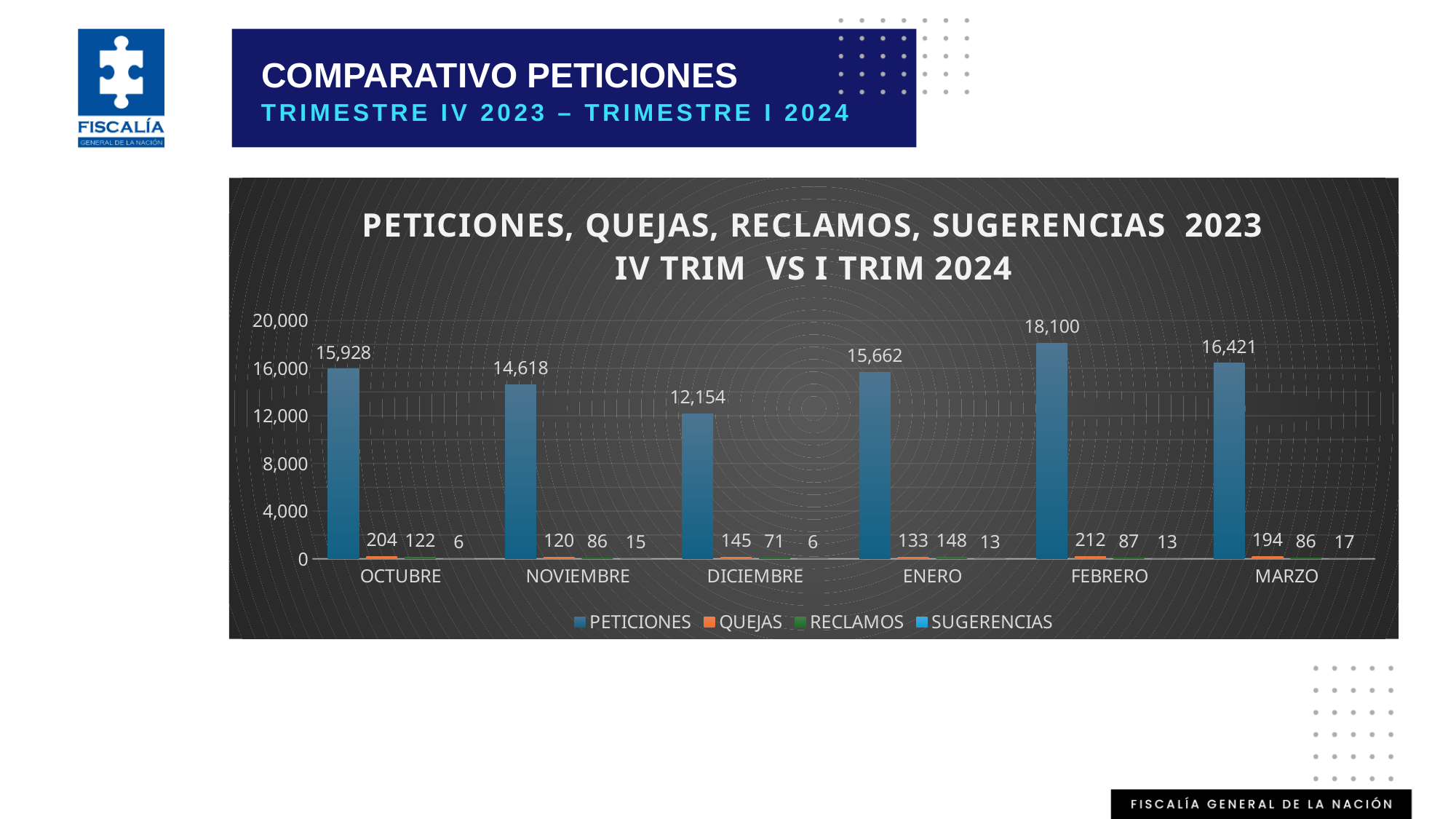
What is the value of PETICIONES for FEBRERO? 18,100 How many series does the legend list? 4 What is the value of RECLAMOS for ENERO? 148 Which month has the lowest value for PETICIONES? DICIEMBRE Which is larger, QUEJAS in NOVIEMBRE or QUEJAS in DICIEMBRE? DICIEMBRE What kind of chart is shown on the slide? Bar chart What is the difference between PETICIONES in FEBRERO and PETICIONES in DICIEMBRE? 5,946 What is the value of SUGERENCIAS for MARZO? 17 Which month has the highest value for PETICIONES? FEBRERO How many months are shown on the x axis? 6 What is the title of the chart? PETICIONES, QUEJAS, RECLAMOS, SUGERENCIAS 2023 IV TRIM VS I TRIM 2024 What is the value of QUEJAS for OCTUBRE? 204